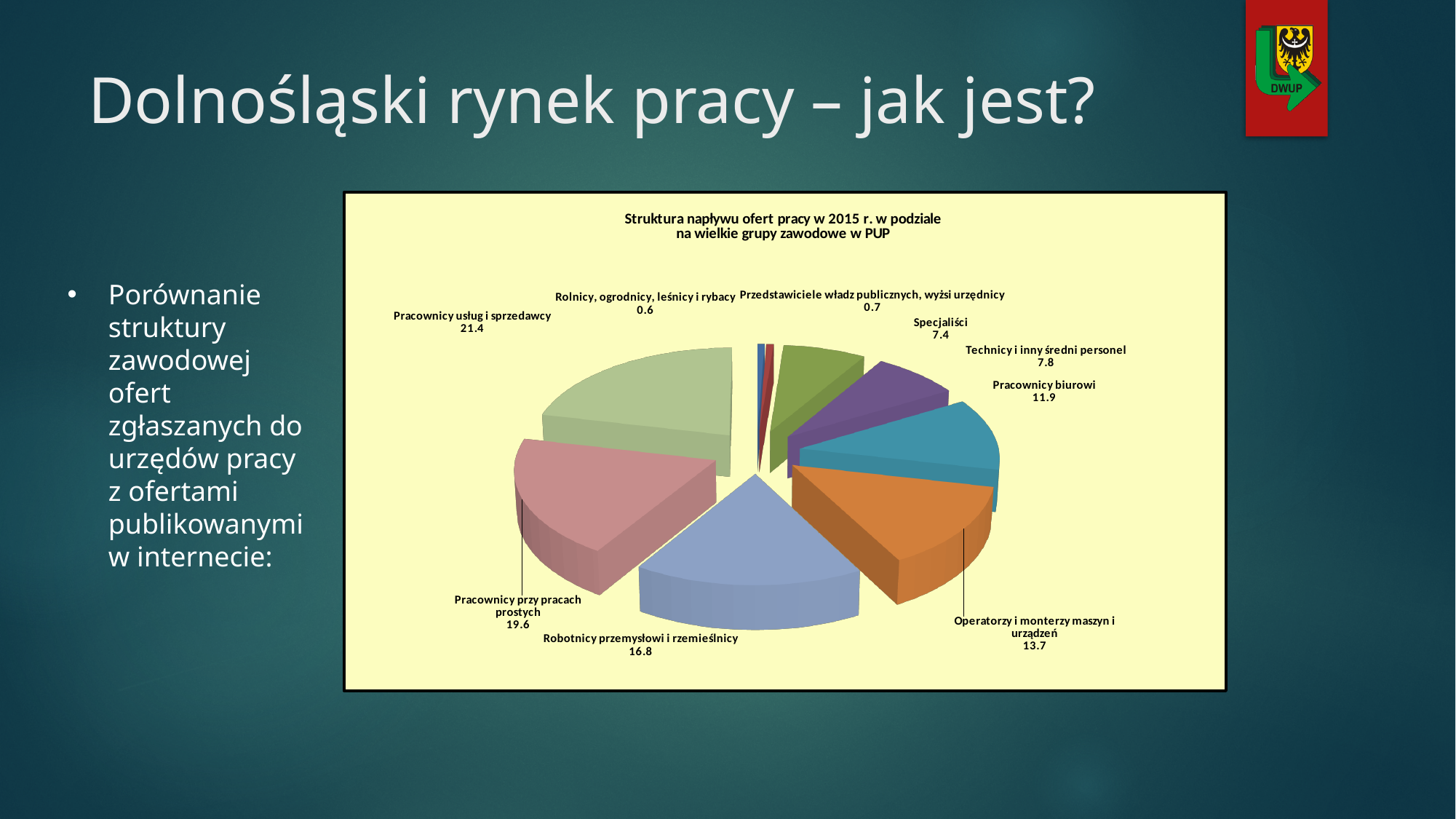
What is the value for Pracownicy biurowi? 11.9 Which category has the lowest value? Rolnicy, ogrodnicy, leśnicy i rybacy What is the value for Specjaliści? 7.4 What is the difference between the values for Technicy i inny średni personel and Specjaliści? 0.4 What is the value for Operatorzy i monterzy maszyn i urządzeń? 13.7 What kind of chart is shown on the slide? Pie chart What is the value for Pracownicy usług i sprzedawcy? 21.4 What is the title of the chart? Struktura napływu ofert pracy w 2015 r. w podziale na wielkie grupy zawodowe w PUP What is the difference between the values for Pracownicy usług i sprzedawcy and Pracownicy przy pracach prostych? 1.8 Which category has the highest value? Pracownicy usług i sprzedawcy How many categories are shown in the pie chart? 9 Which is larger, the value for Robotnicy przemysłowi i rzemieślnicy or the value for Operatorzy i monterzy maszyn i urządzeń? Robotnicy przemysłowi i rzemieślnicy